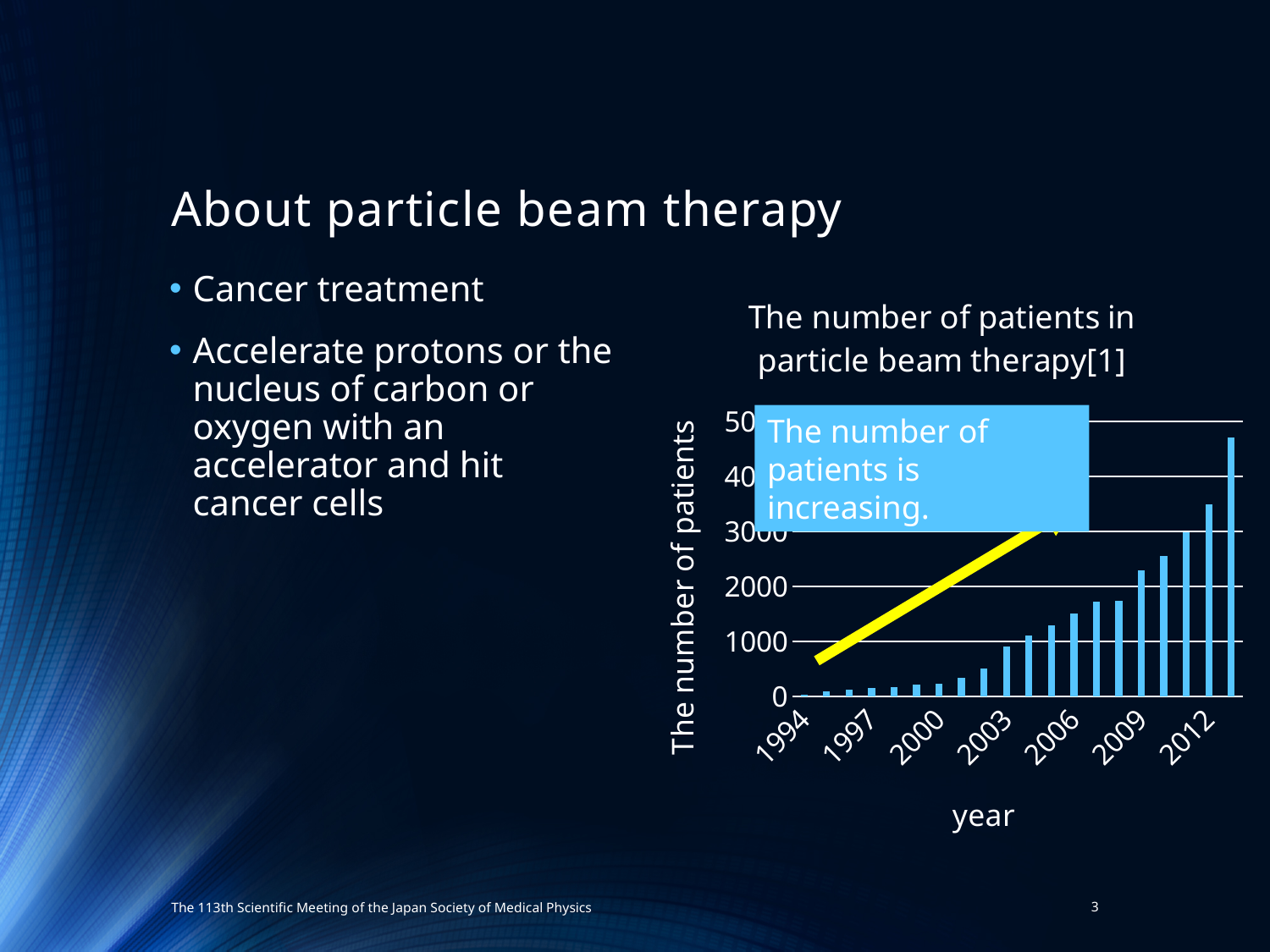
What is the label of the x axis of the chart? year What is the title of the chart? The number of patients in particle beam therapy[1] What kind of chart is shown on the slide? bar chart Which year has a larger value, 2006 or 2012? 2012 Is the value for 2009 greater or less than 2000? greater Is the value for 2012 greater or less than 3000? greater Which labelled year has the lowest value in the chart? 1994 Is the value for 2000 greater or less than 1000? less Do the values in the chart rise or fall from 1994 to 2012? rise